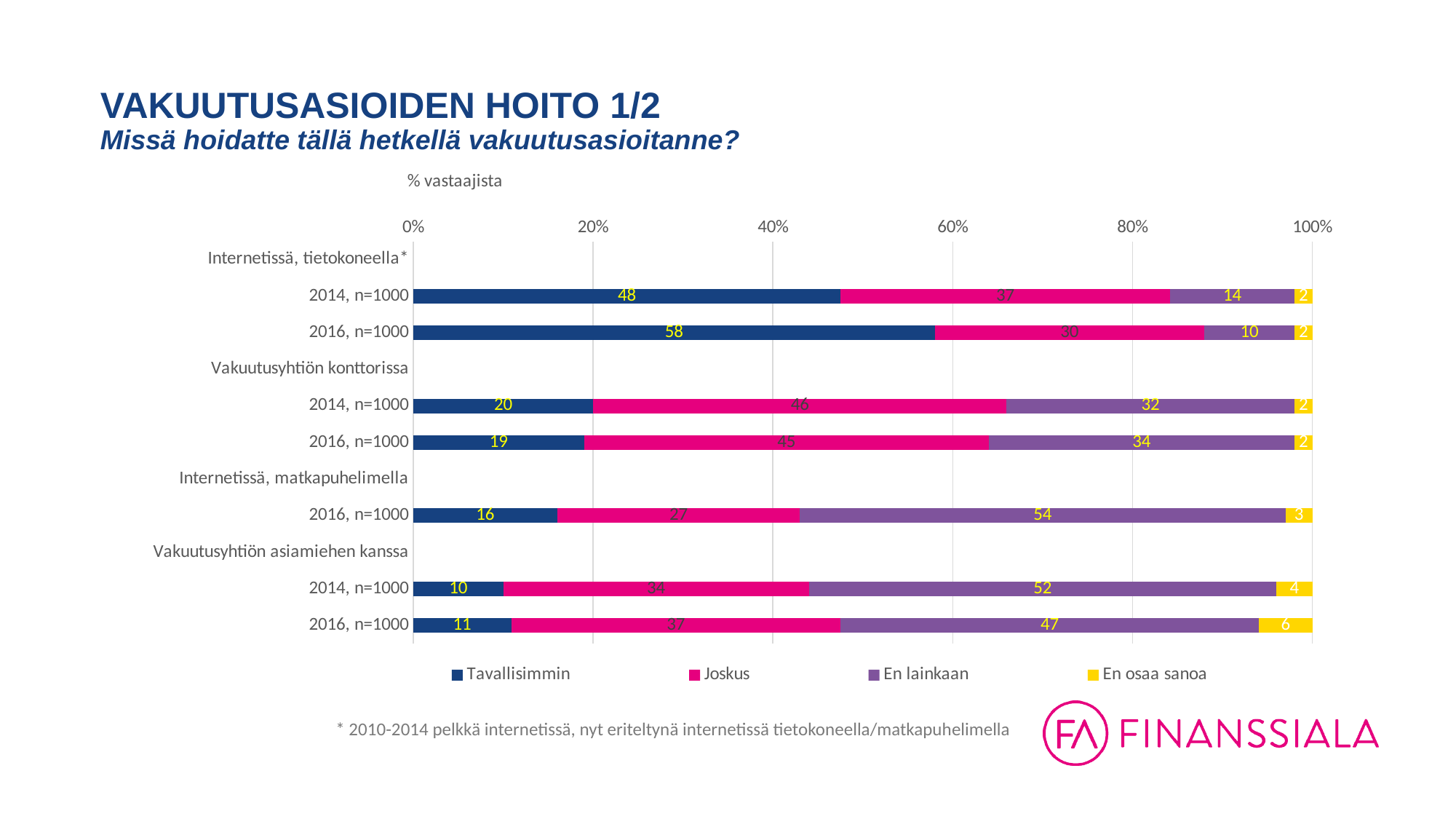
What is the total of the stacked bar for 'Vakuutusyhtiön konttorissa', 2016, n=1000? 100 Which bar has the lowest 'Tavallisimmin' value? Vakuutusyhtiön asiamiehen kanssa, 2014, n=1000 What is the 'Joskus' value for 'Vakuutusyhtiön konttorissa' in 2014, n=1000? 46 What is the 'Tavallisimmin' value for 'Internetissä, tietokoneella*' in 2016, n=1000? 58 What is the 'En lainkaan' value for 'Internetissä, matkapuhelimella' in 2016, n=1000? 54 Which is larger: the 'En lainkaan' value for 'Vakuutusyhtiön asiamiehen kanssa' in 2014 or in 2016? 2014 What type of chart is shown on the slide? Stacked bar chart Which bar has the highest 'Tavallisimmin' value? Internetissä, tietokoneella*, 2016, n=1000 How many series does the legend list? 4 How many bars are plotted in the chart? 7 By how much did the 'Tavallisimmin' value for 'Internetissä, tietokoneella*' change from 2014 to 2016? 10 What is the 'En osaa sanoa' value for 'Vakuutusyhtiön asiamiehen kanssa' in 2016, n=1000? 6